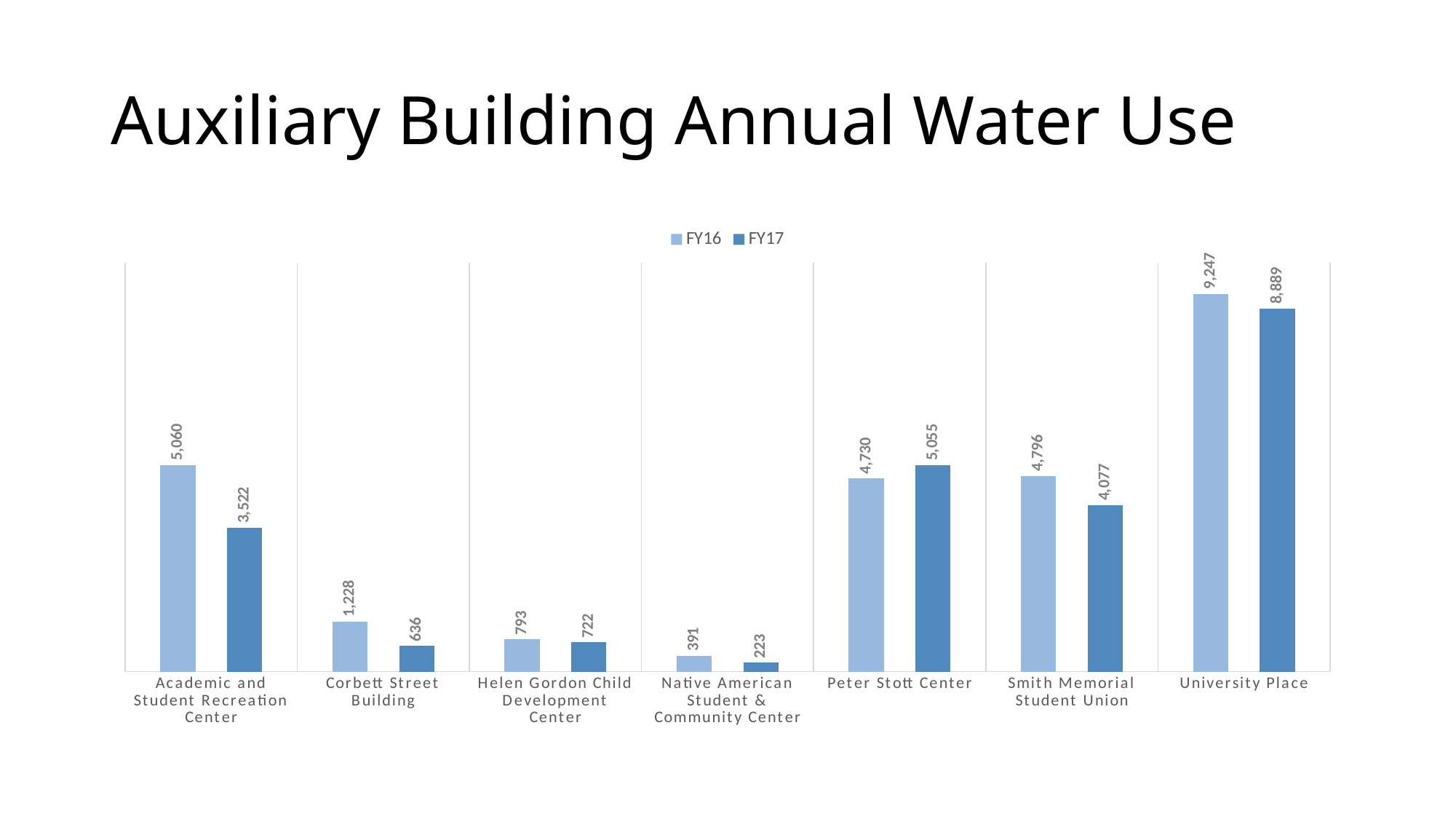
What is the FY16 value for University Place? 9,247 Which building has the lowest FY16 value? Native American Student & Community Center Which is larger for Peter Stott Center, the FY16 value or the FY17 value? FY17 What kind of chart is shown on the slide? Bar chart How many series does the legend list? 2 How many buildings are shown on the x axis? 7 What is the difference between the FY16 and FY17 values for University Place? 358 Which building has the highest FY17 value? University Place What is the difference between the FY16 and FY17 values for Corbett Street Building? 592 What is the title of the slide? Auxiliary Building Annual Water Use What is the FY17 value for Academic and Student Recreation Center? 3,522 What is the FY17 value for Native American Student & Community Center? 223